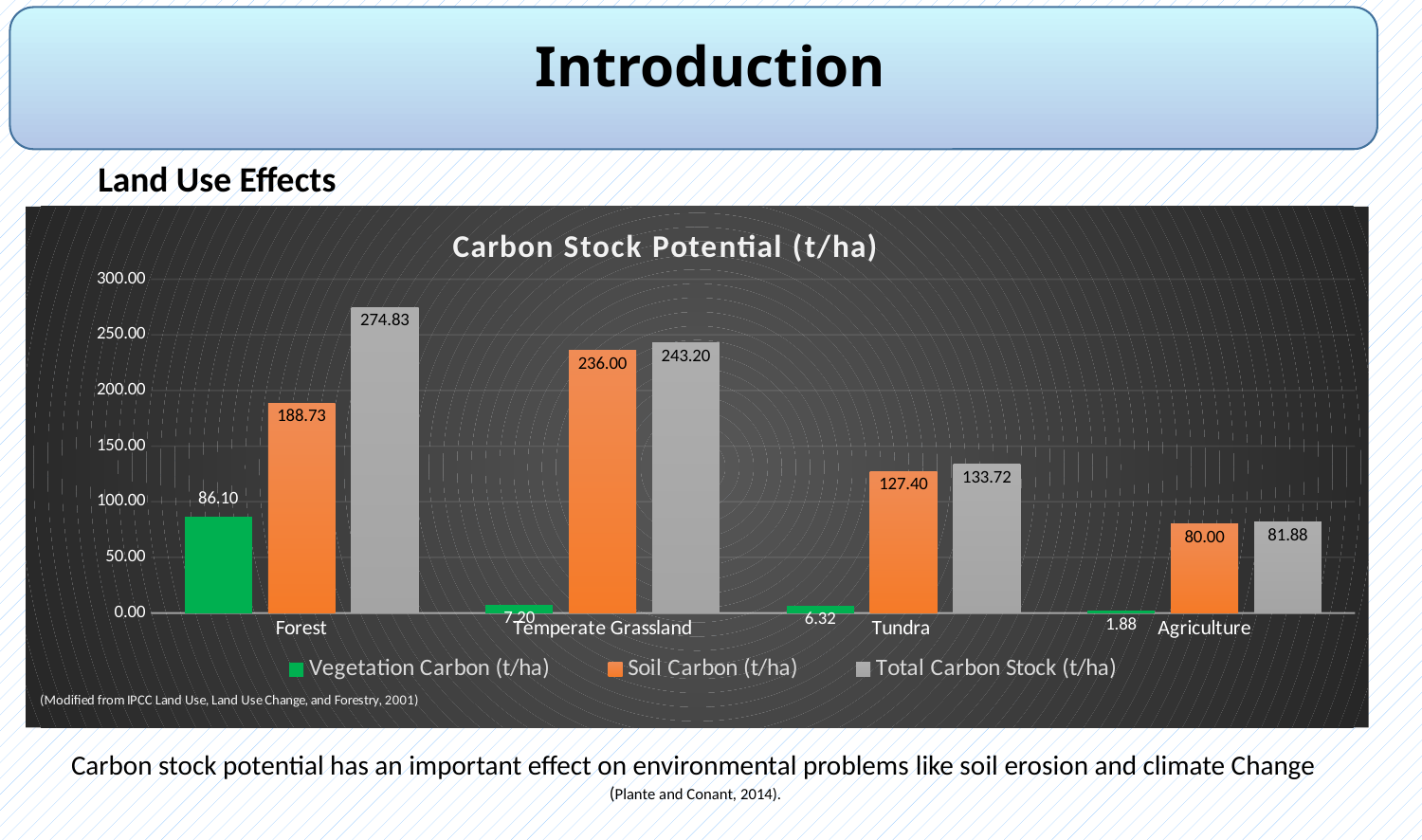
How many land use categories are shown on the x axis? 4 What is the Soil Carbon (t/ha) value for Temperate Grassland? 236.00 What type of chart is shown on the slide? Bar chart What is the difference between the Soil Carbon (t/ha) values for Forest and Tundra? 61.33 What is the Total Carbon Stock (t/ha) value for Forest? 274.83 How many series does the legend list? 3 Which category has the lowest Vegetation Carbon (t/ha)? Agriculture Is the Total Carbon Stock (t/ha) value for Agriculture greater or less than 100.00? less Which is larger: the Soil Carbon (t/ha) for Temperate Grassland or the Soil Carbon (t/ha) for Forest? Temperate Grassland Which category has the highest Total Carbon Stock (t/ha)? Forest What is the Vegetation Carbon (t/ha) value for Tundra? 6.32 What is the title of the chart? Carbon Stock Potential (t/ha)